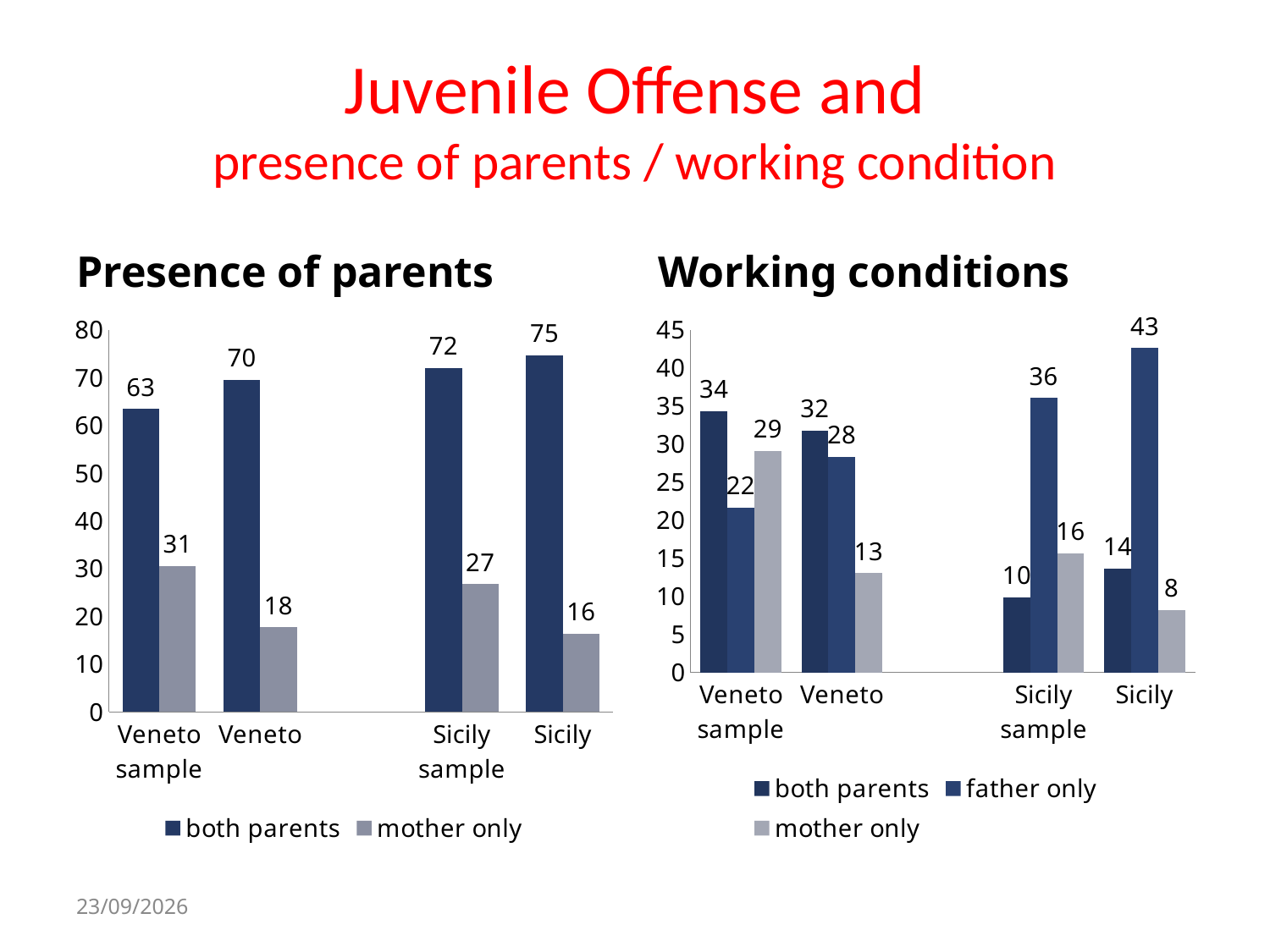
In the 'Presence of parents' chart, which category has the highest 'both parents' value? Sicily In the 'Presence of parents' chart, how many series does the legend list? 2 What type of chart is the 'Working conditions' chart? Bar chart In the 'Working conditions' chart, what is the value for 'mother only' in the Veneto sample? 29 In the 'Presence of parents' chart, what is the value for 'both parents' in the Veneto sample? 63 In the 'Presence of parents' chart, what is the value for 'mother only' in Sicily? 16 In the 'Presence of parents' chart, what is the difference between 'both parents' and 'mother only' for Veneto? 52 In the 'Working conditions' chart, which category has the lowest 'mother only' value? Sicily In the 'Working conditions' chart, what is the value for 'father only' in Sicily? 43 In the 'Working conditions' chart, what is the difference between 'father only' and 'both parents' for Sicily? 29 In the 'Working conditions' chart, which is larger for the Sicily sample: 'both parents' or 'father only'? father only In the 'Working conditions' chart, how many series does the legend list? 3